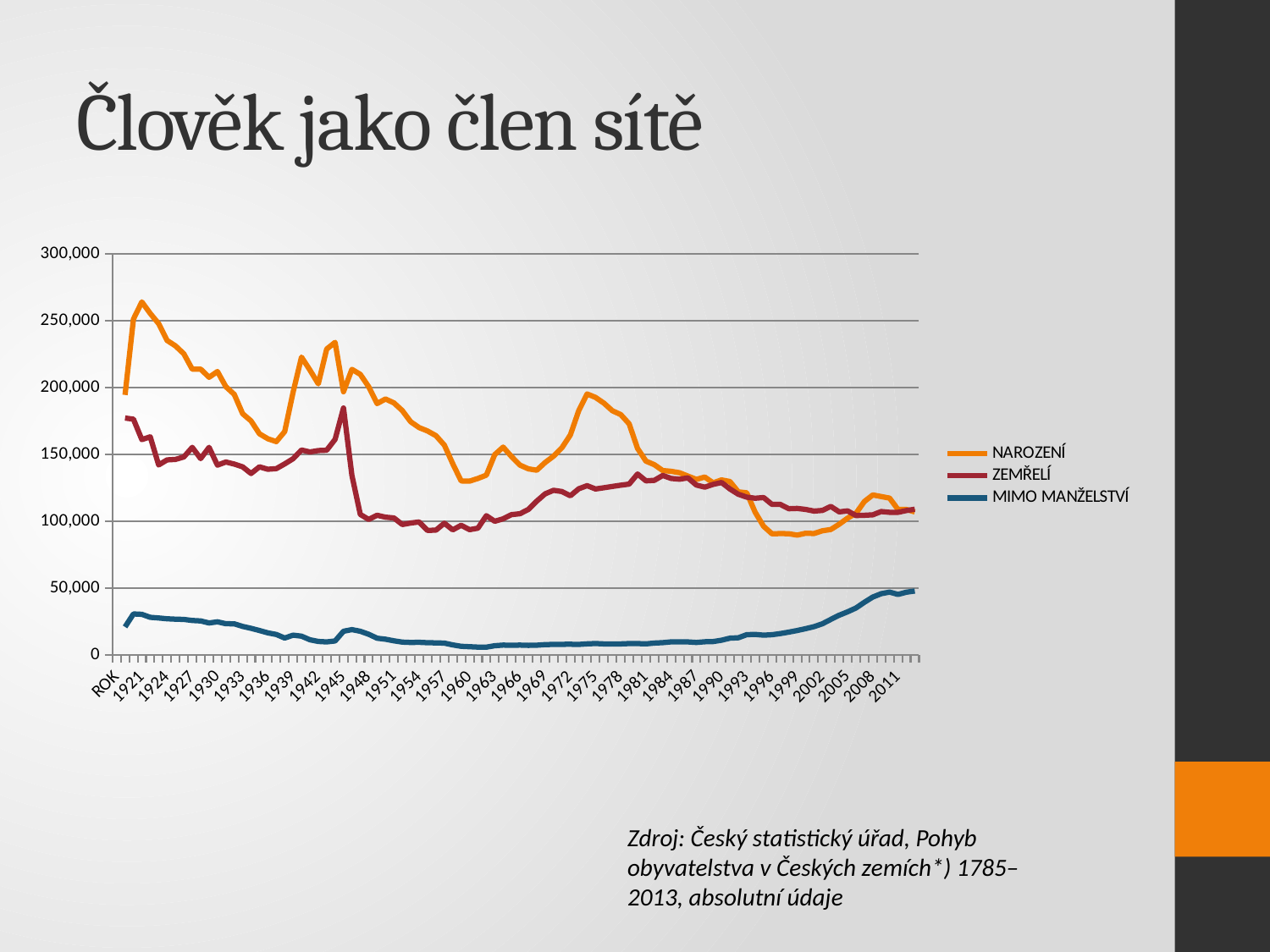
Which series reaches the highest value anywhere on the chart? NAROZENÍ Which series has the higher value in 1999, NAROZENÍ or ZEMŘELÍ? ZEMŘELÍ Which series is shown in blue in the chart? MIMO MANŽELSTVÍ What kind of chart is shown on the slide? line chart Is the value for NAROZENÍ in 1921 greater or less than 250,000? greater Which series is shown in orange in the chart? NAROZENÍ Is the value for NAROZENÍ in 1999 greater or less than 100,000? less Is the value for MIMO MANŽELSTVÍ in 2011 greater or less than 100,000? less How many series does the chart legend list? 3 Which series has the higher value in 1975, NAROZENÍ or ZEMŘELÍ? NAROZENÍ Does the MIMO MANŽELSTVÍ series rise or fall between 1993 and 2011? rise